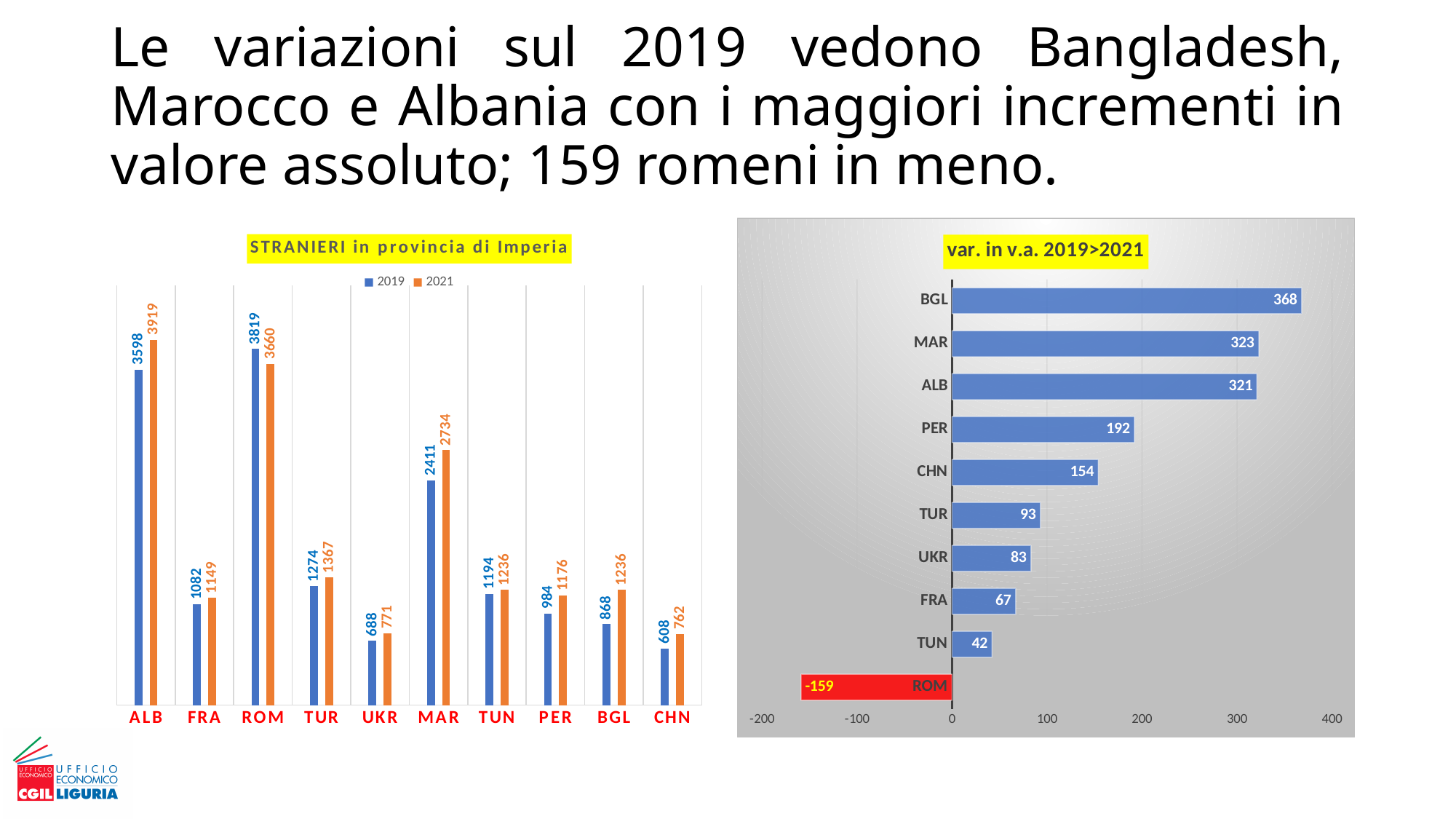
In the chart 'STRANIERI in provincia di Imperia', is the 2019 value for ROM larger or smaller than its 2021 value? larger In the chart 'STRANIERI in provincia di Imperia', what is the 2021 value for ALB? 3919 In the chart 'STRANIERI in provincia di Imperia', which category has the lowest 2021 value? CHN How many series does the legend of the chart 'STRANIERI in provincia di Imperia' list? 2 What kind of chart is 'var. in v.a. 2019>2021'? bar chart In the chart 'var. in v.a. 2019>2021', what is the value for PER? 192 In the chart 'var. in v.a. 2019>2021', which category has the lowest value? ROM In the chart 'STRANIERI in provincia di Imperia', what is the difference between the 2021 and 2019 values for BGL? 368 In the chart 'STRANIERI in provincia di Imperia', which category has the highest 2019 value? ROM In the chart 'STRANIERI in provincia di Imperia', what is the 2019 value for MAR? 2411 How many categories are shown in the chart 'STRANIERI in provincia di Imperia'? 10 In the chart 'var. in v.a. 2019>2021', what is the difference between the values for BGL and MAR? 45